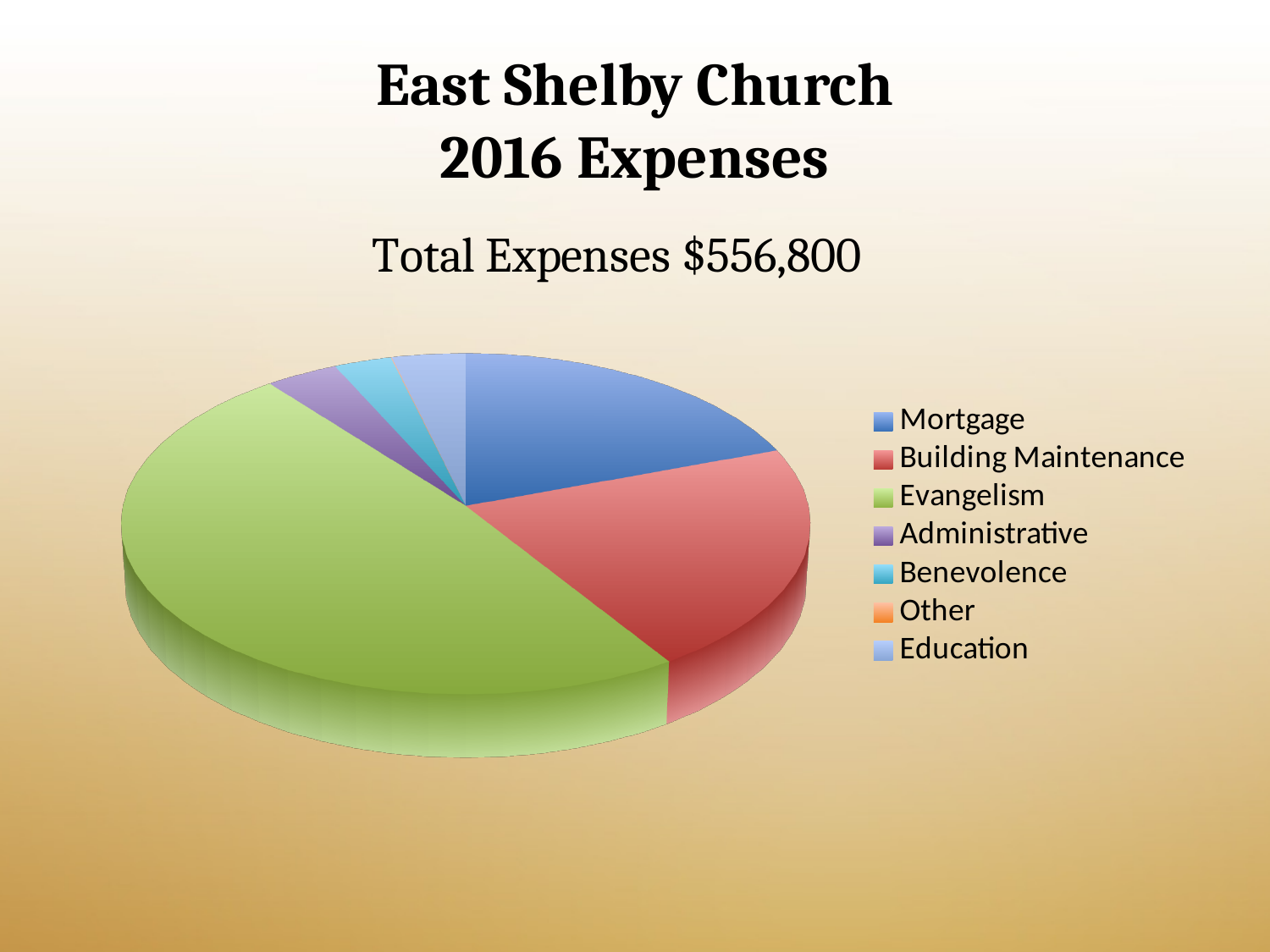
Which slice is larger, Mortgage or Administrative? Mortgage Which slice is larger, Building Maintenance or Benevolence? Building Maintenance Which slice is larger, Evangelism or Building Maintenance? Evangelism Which category has the largest slice of the pie chart? Evangelism How many categories does the legend of the pie chart list? 7 What total expenses figure is printed on the slide? $556,800 What colour is the Evangelism slice in the pie chart? green What kind of chart is shown on the slide? pie chart